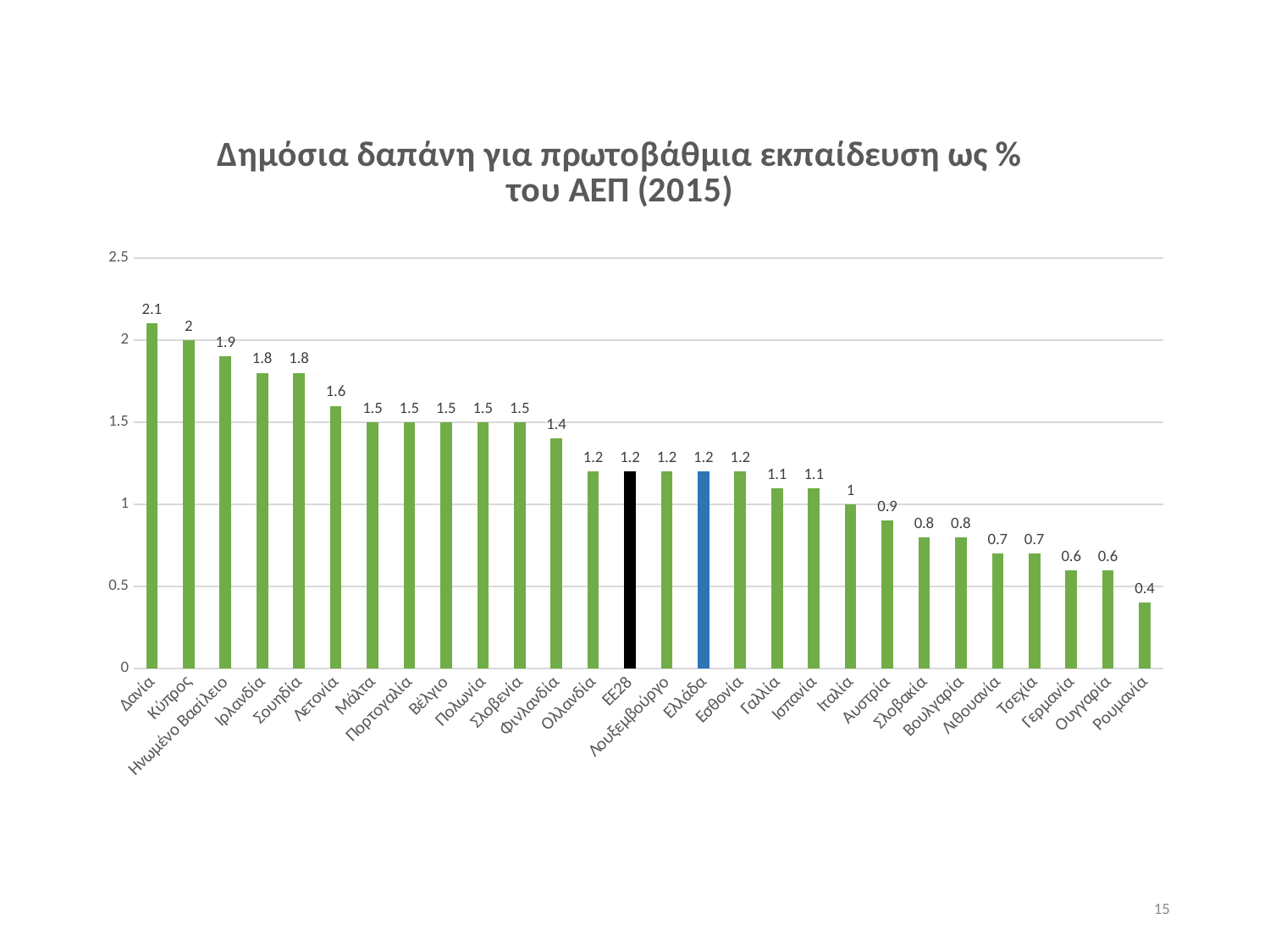
Which is larger, the value for Κύπρος or the value for Γερμανία? Κύπρος What is the value for Ρουμανία? 0.4 Which category has the highest value? Δανία What is the value for Ελλάδα? 1.2 What is the value for ΕΕ28? 1.2 How many bars are shown in the chart? 28 What is the value for Δανία? 2.1 What is the difference between the values for Δανία and Ρουμανία? 1.7 What colour is the bar for Ελλάδα? Blue What kind of chart is shown on the slide? Bar chart Which category has the lowest value? Ρουμανία Do the values rise or fall from left to right along the x axis? Fall